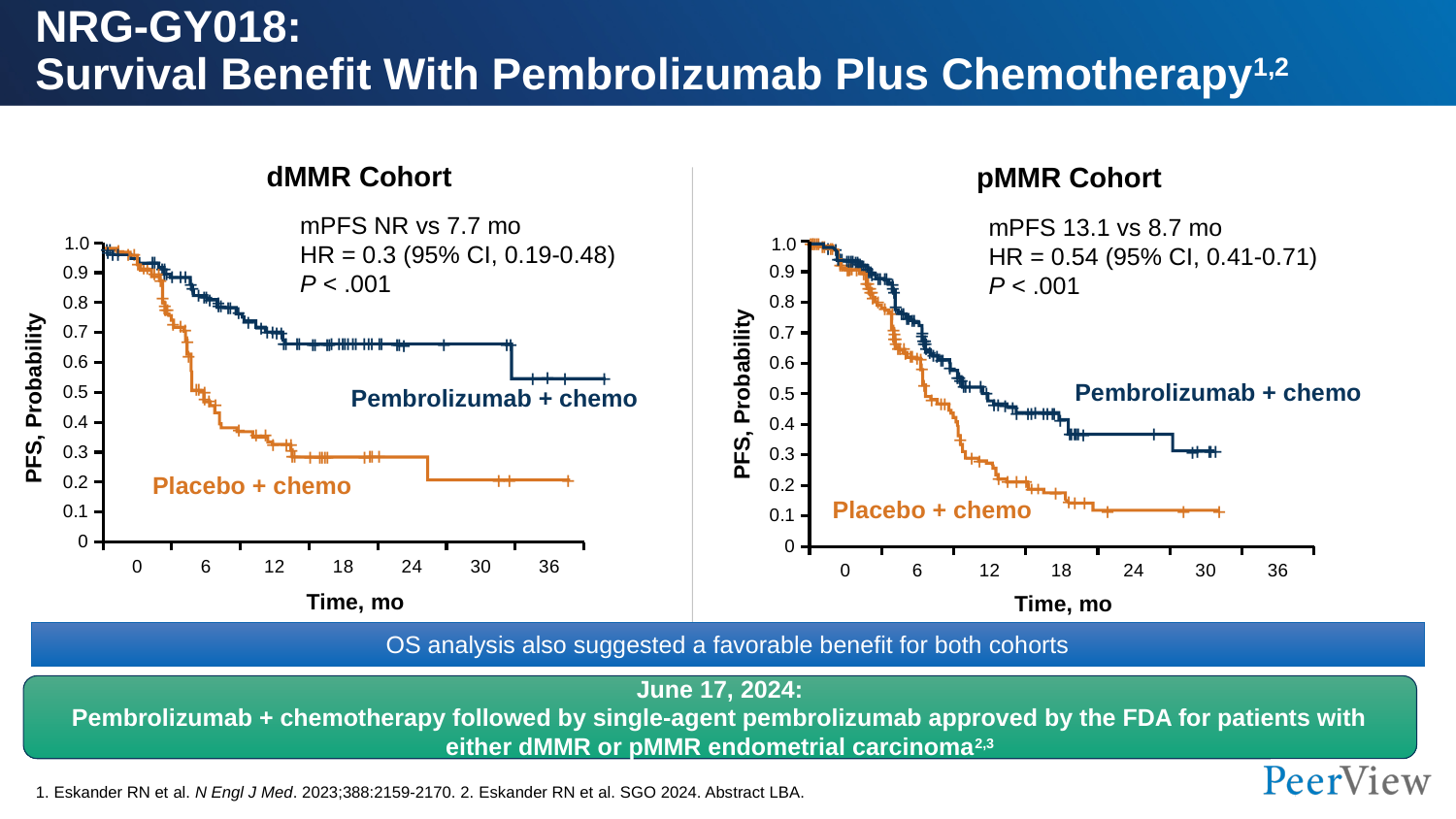
In the pMMR Cohort chart, is the PFS probability for Placebo + chemo at 24 months greater or less than 0.2? less What is the x-axis label on both charts? Time, mo What kind of chart is shown for the dMMR Cohort? Line chart (Kaplan-Meier survival curve) In the dMMR Cohort chart, what is the median PFS for the two arms? NR vs 7.7 mo In the pMMR Cohort chart, what is the 95% CI for the hazard ratio? 0.41-0.71 In the dMMR Cohort chart, what is the hazard ratio? 0.3 In the dMMR Cohort chart, is the PFS probability for Pembrolizumab + chemo at 24 months greater or less than 0.5? greater In the dMMR Cohort chart, which curve is higher at 24 months, Pembrolizumab + chemo or Placebo + chemo? Pembrolizumab + chemo How many curves (series) are plotted in the pMMR Cohort chart? 2 In the pMMR Cohort chart, what is the median PFS for the two arms? 13.1 vs 8.7 mo In the dMMR Cohort chart, what is the 95% CI for the hazard ratio? 0.19-0.48 In the pMMR Cohort chart, what is the hazard ratio? 0.54